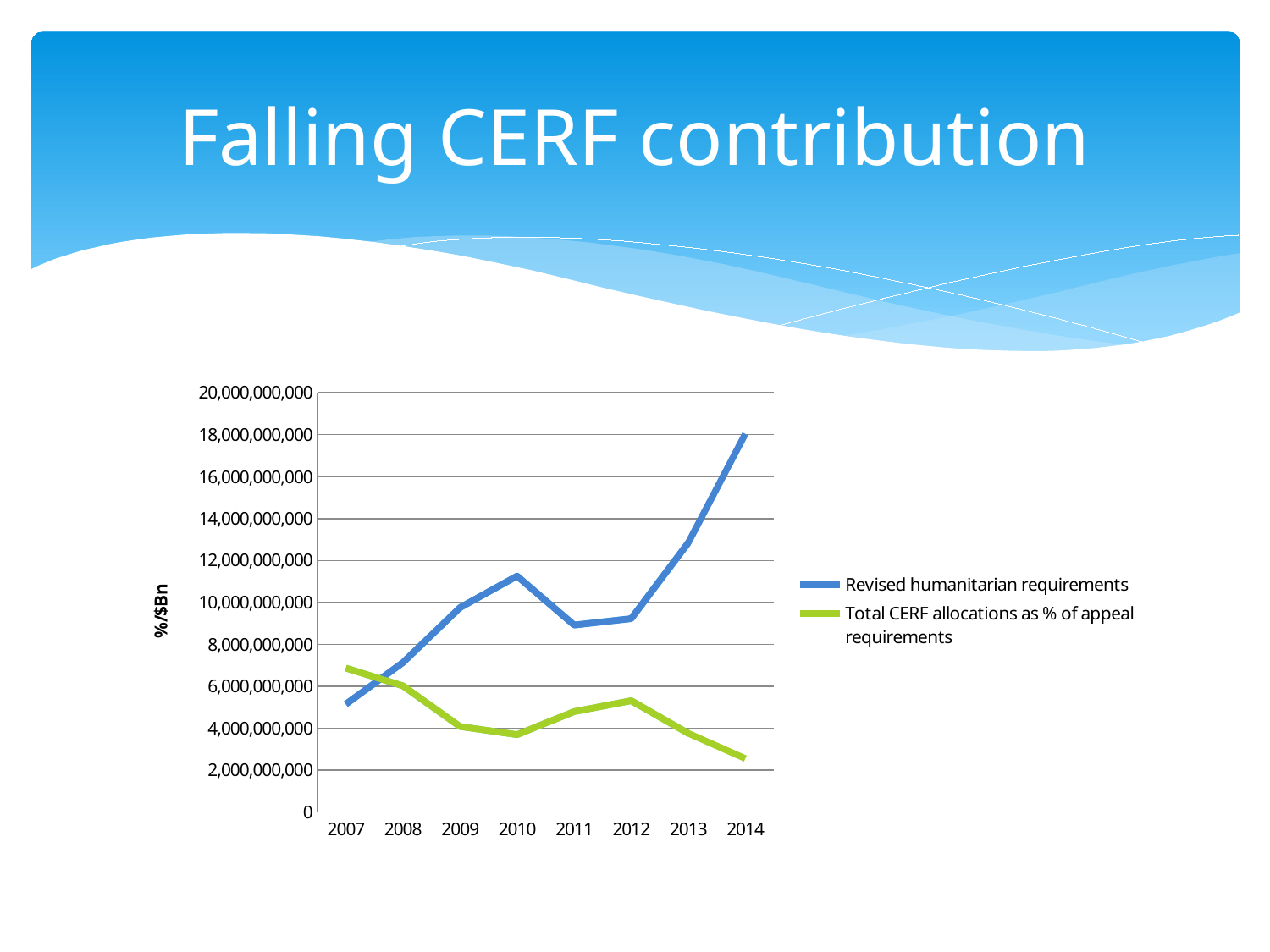
In which year is the Total CERF allocations as % of appeal requirements series lowest? 2014 In which year is the Revised humanitarian requirements series lowest? 2007 Is the value for Revised humanitarian requirements in 2014 greater or less than 16,000,000,000? greater What kind of chart is shown on the slide? line chart In which year is the Total CERF allocations as % of appeal requirements series highest? 2007 What is the label on the vertical axis of the chart? %/$Bn Which series has the larger value in 2012, Revised humanitarian requirements or Total CERF allocations as % of appeal requirements? Revised humanitarian requirements How many series does the legend list? 2 Does the Total CERF allocations as % of appeal requirements series generally rise or fall from 2007 to 2014? fall In which year is the Revised humanitarian requirements series highest? 2014 Is the value for Total CERF allocations as % of appeal requirements in 2010 greater or less than 4,000,000,000? less How many years are plotted along the x axis? 8